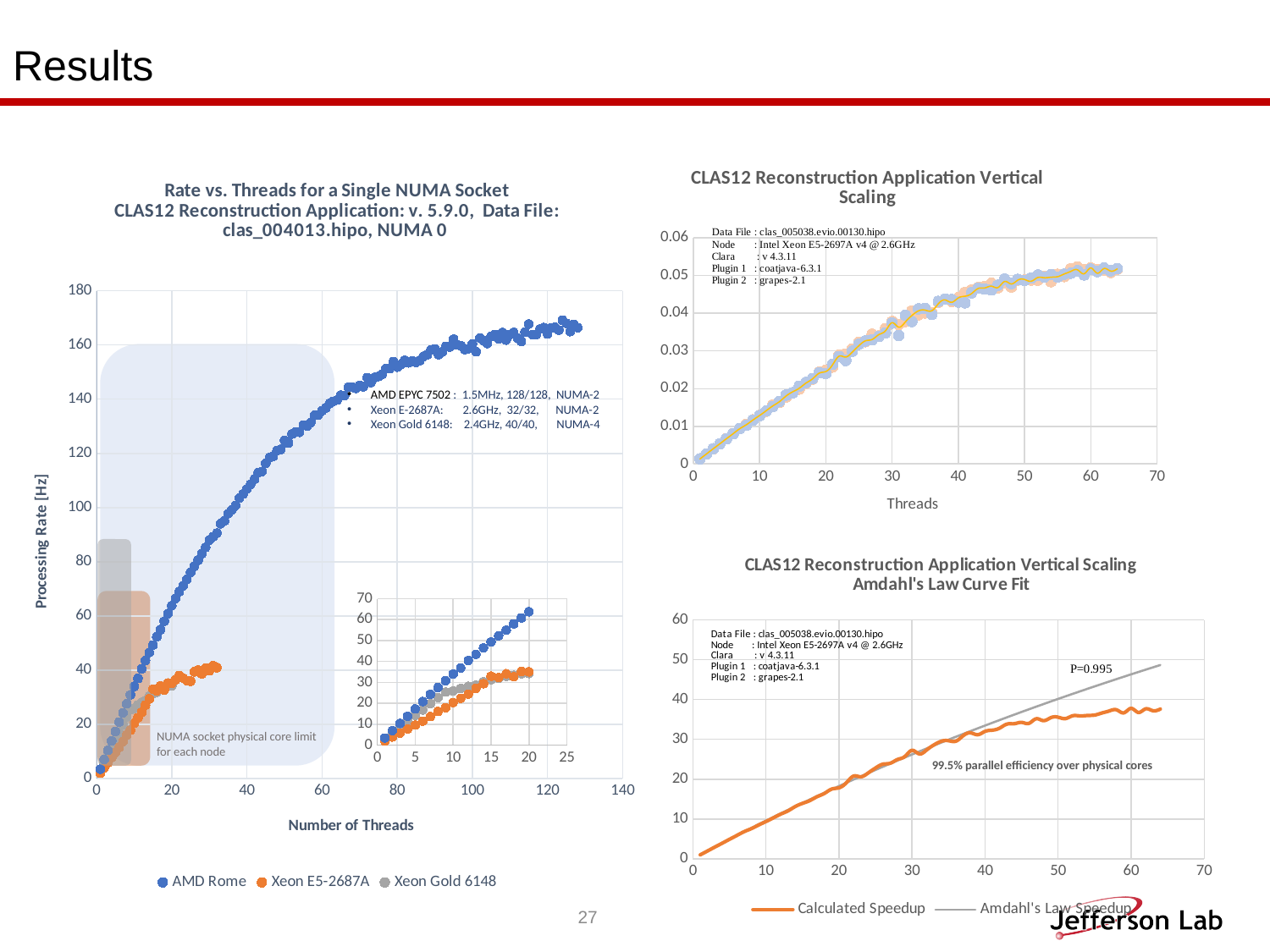
On the bottom-right chart 'Amdahl's Law Curve Fit', what value of P is annotated on the chart? P=0.995 On the left chart 'Rate vs. Threads for a Single NUMA Socket', does the processing rate for AMD Rome rise or fall as the number of threads increases? rise On the left chart 'Rate vs. Threads for a Single NUMA Socket', which series reaches the highest processing rate? AMD Rome On the left chart 'Rate vs. Threads for a Single NUMA Socket', how many series does the legend list? 3 On the left chart 'Rate vs. Threads for a Single NUMA Socket', is the highest processing rate reached by Xeon E5-2687A greater or less than 60? less On the top-right chart 'CLAS12 Reconstruction Application Vertical Scaling', is the value at 60 threads greater or less than 0.04? greater On the bottom-right chart 'Amdahl's Law Curve Fit', is the Calculated Speedup at 60 threads greater or less than 40? less On the bottom-right chart 'Amdahl's Law Curve Fit', at 60 threads, which is larger: Calculated Speedup or Amdahl's Law Speedup? Amdahl's Law Speedup On the bottom-right chart 'Amdahl's Law Curve Fit', how many series does the legend list? 2 On the top-right chart 'CLAS12 Reconstruction Application Vertical Scaling', do the values rise or fall as the number of threads increases? rise On the left chart 'Rate vs. Threads for a Single NUMA Socket', what is the label of the y axis? Processing Rate [Hz]